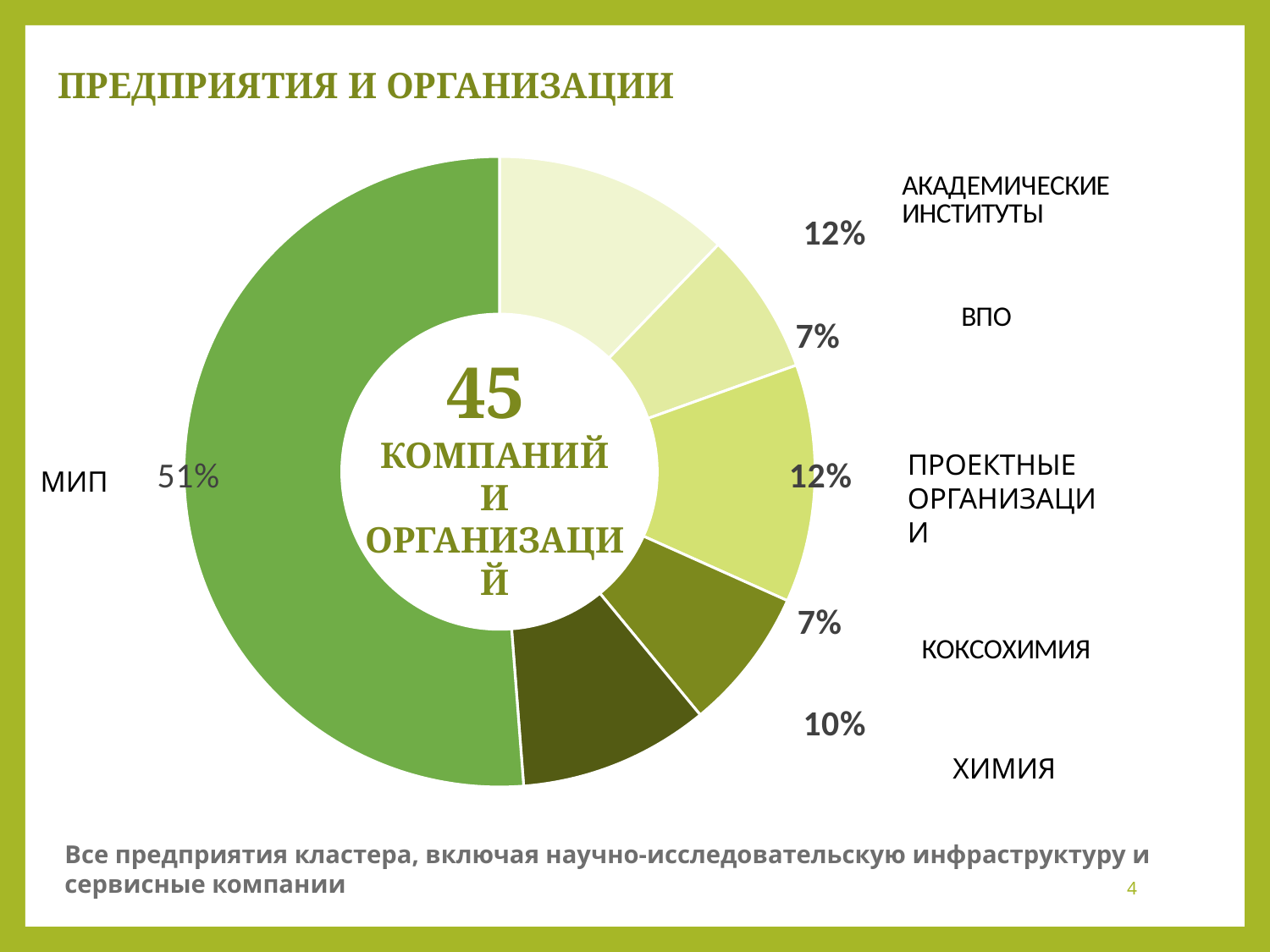
What is the difference in percentage points between МИП and ХИМИЯ? 41 What percentage is shown for КОКСОХИМИЯ? 7% Which category has the largest share of the chart? МИП Which is larger, the share for ХИМИЯ or the share for ВПО? ХИМИЯ What kind of chart is shown on the slide? Donut (pie) chart What share of the chart does МИП account for? 51% What percentage is shown for ХИМИЯ? 10% What percentage is shown for АКАДЕМИЧЕСКИЕ ИНСТИТУТЫ? 12% What is the title of the slide? ПРЕДПРИЯТИЯ И ОРГАНИЗАЦИИ What is the combined share of ВПО and КОКСОХИМИЯ? 14% What number is printed in the centre of the chart? 45 How many categories (slices) does the chart show? 6